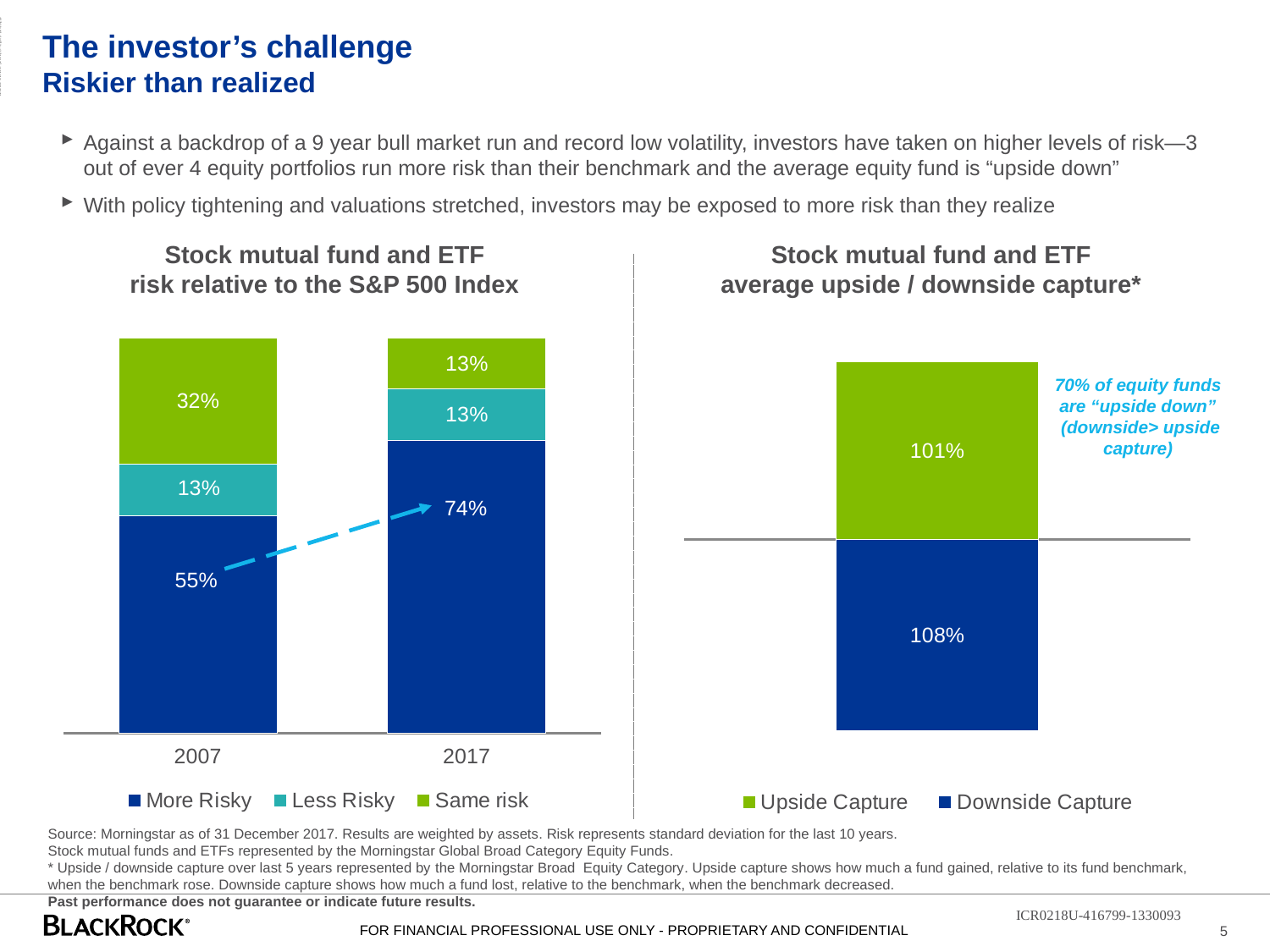
In the 'Stock mutual fund and ETF risk relative to the S&P 500 Index' chart, by how many percentage points did the More Risky share change from 2007 to 2017? 19 percentage points In the 'Stock mutual fund and ETF risk relative to the S&P 500 Index' chart, what is the Less Risky value for 2007? 13% In the 'Stock mutual fund and ETF average upside / downside capture' chart, what is the Downside Capture value? 108% In the 'Stock mutual fund and ETF risk relative to the S&P 500 Index' chart, how many years are shown on the x axis? 2 In the 'Stock mutual fund and ETF average upside / downside capture' chart, which is larger, Upside Capture or Downside Capture? Downside Capture In the 'Stock mutual fund and ETF risk relative to the S&P 500 Index' chart, what is the More Risky value for 2017? 74% What kind of chart is the 'Stock mutual fund and ETF risk relative to the S&P 500 Index' chart? Stacked bar chart In the 'Stock mutual fund and ETF risk relative to the S&P 500 Index' chart, how many series does the legend list? 3 In the 'Stock mutual fund and ETF risk relative to the S&P 500 Index' chart, does the More Risky value rise or fall from 2007 to 2017? Rise In the 'Stock mutual fund and ETF risk relative to the S&P 500 Index' chart, which year has the larger Same risk value, 2007 or 2017? 2007 In the 'Stock mutual fund and ETF average upside / downside capture' chart, what is the Upside Capture value? 101% In the 'Stock mutual fund and ETF risk relative to the S&P 500 Index' chart, what is the Same risk value for 2007? 32%